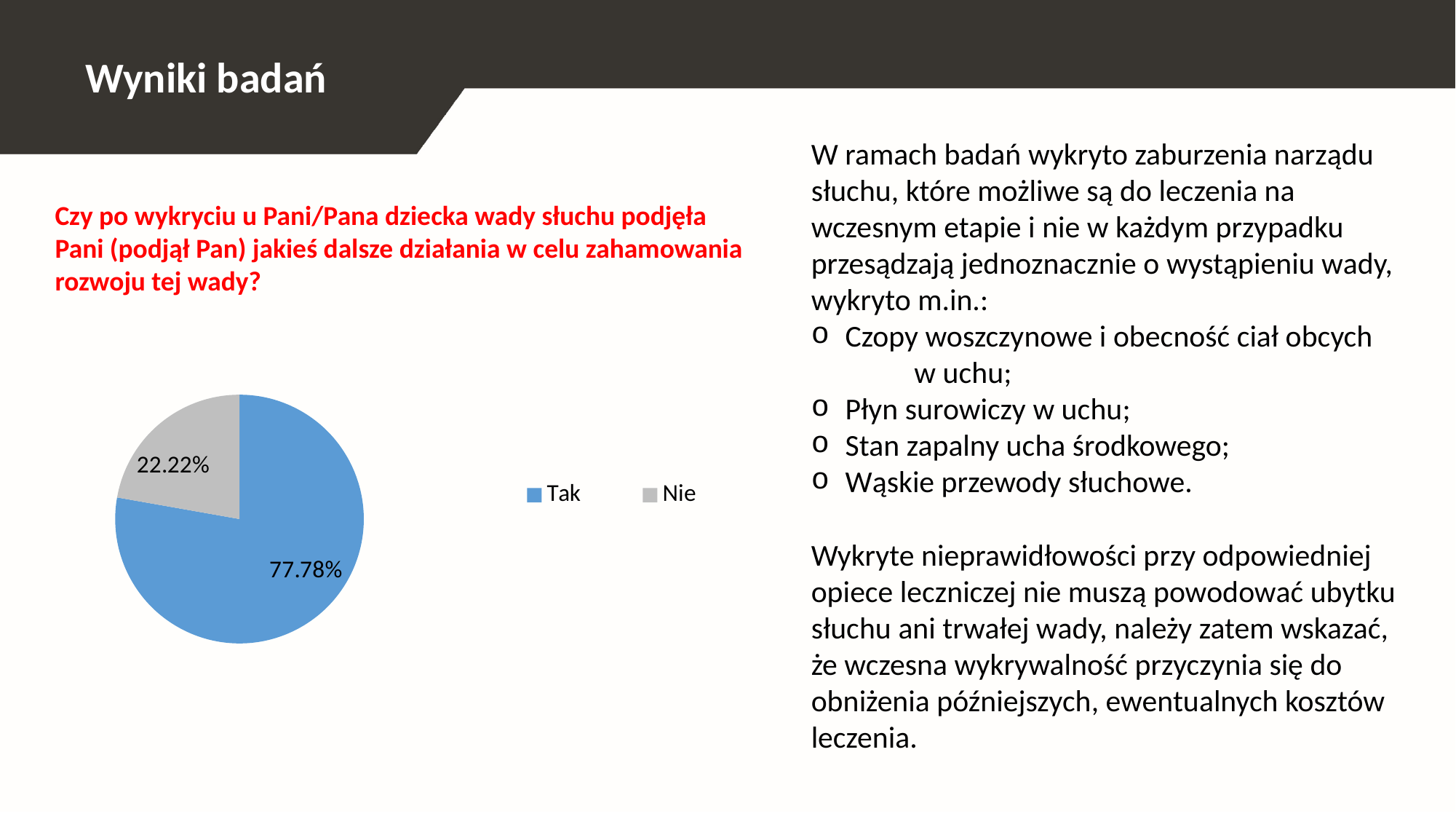
Which slice of the pie is the smallest? Nie How many slices does the pie chart have? 2 How many entries does the legend list? 2 Which slice of the pie is the largest? Tak Which is larger, the "Tak" slice or the "Nie" slice? Tak What share of the pie does "Nie" represent? 22.22% What colour is the "Nie" slice? grey What is the difference in percentage points between the "Tak" and "Nie" slices? 55.56 What kind of chart is shown on the slide? pie chart What share of the pie does "Tak" represent? 77.78% What colour is the "Tak" slice? blue